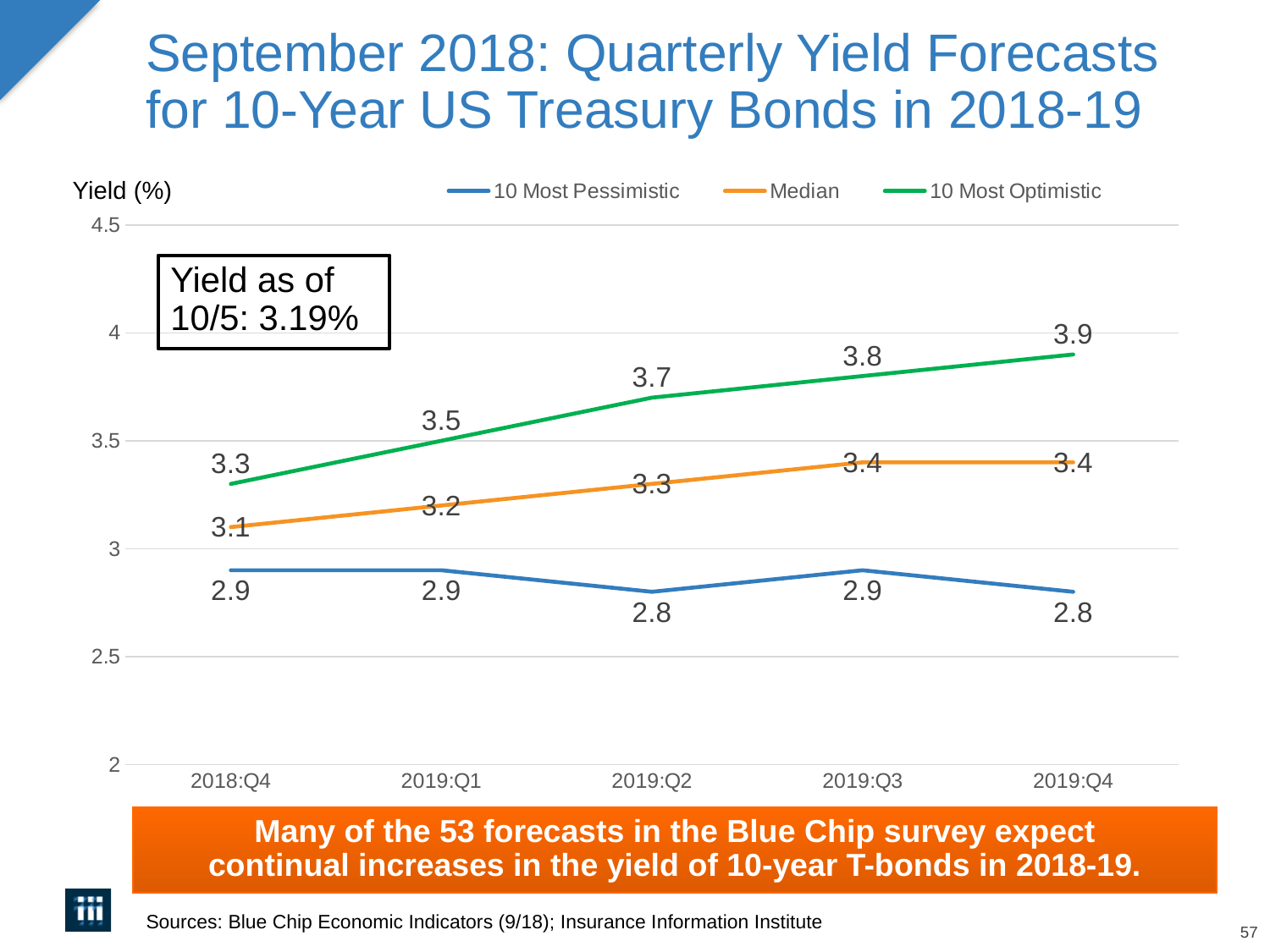
What is the 10 Most Optimistic forecast for 2019:Q4? 3.9 How many series does the legend list? 3 What is the Median forecast for 2019:Q2? 3.3 In which quarter is the Median forecast lowest? 2018:Q4 In which quarter is the 10 Most Optimistic forecast highest? 2019:Q4 What type of chart is shown on the slide? Line chart What yield as of 10/5 is noted in the box on the chart? 3.19% What is the 10 Most Pessimistic forecast for 2018:Q4? 2.9 What is the difference between the 10 Most Optimistic and 10 Most Pessimistic forecasts for 2019:Q4? 1.1 Does the 10 Most Optimistic series rise or fall from 2018:Q4 to 2019:Q4? Rise Which is larger, the Median forecast for 2019:Q3 or the 10 Most Optimistic forecast for 2018:Q4? Median forecast for 2019:Q3 How many quarters are plotted along the x axis? 5